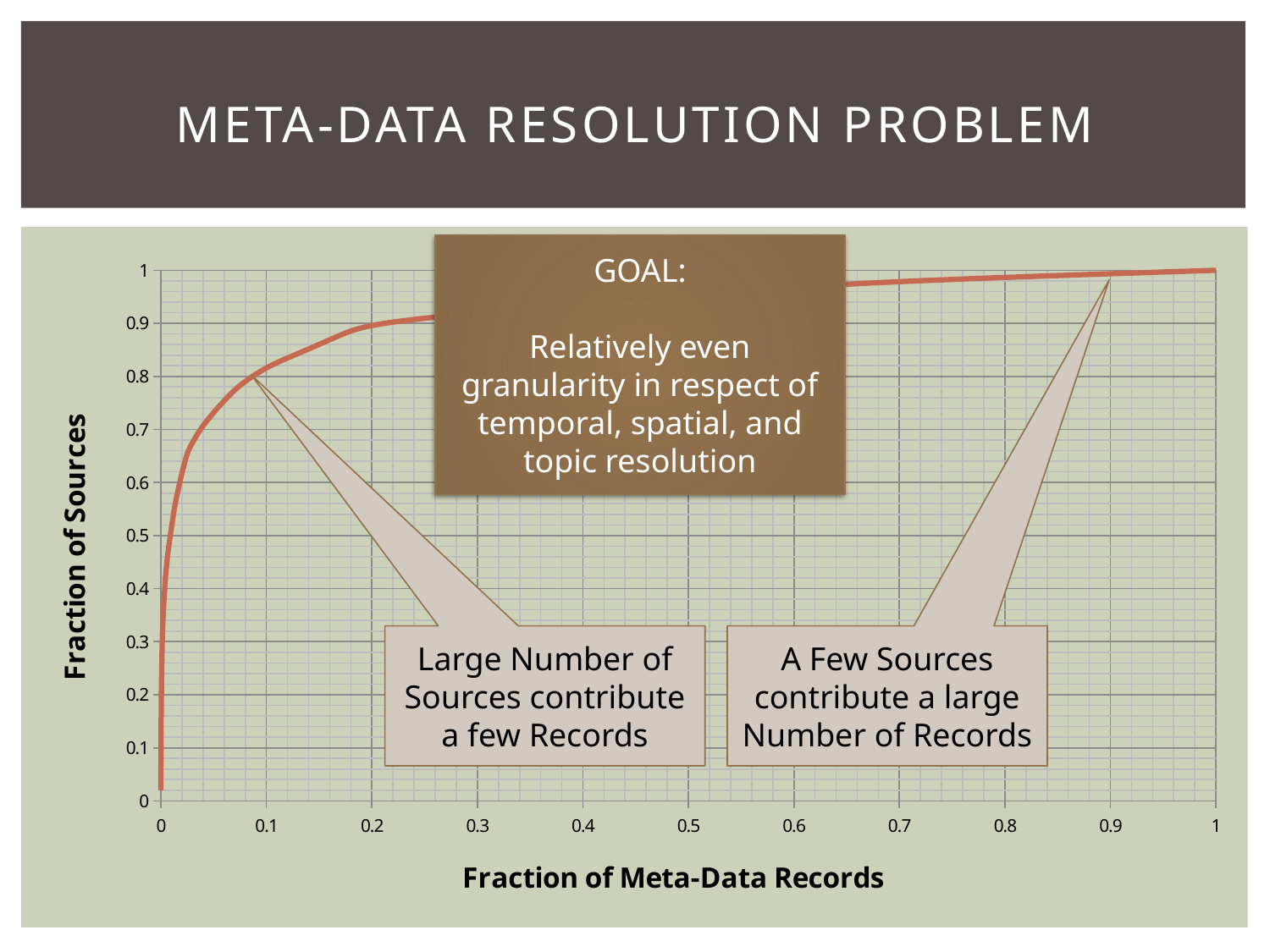
Does the plotted curve rise or fall as the fraction of meta-data records increases along the x axis? rise Which is larger: the curve's value at a fraction of meta-data records of 0.1 or at 0.9? 0.9 Is the value of the curve at a fraction of meta-data records of 0.9 greater or less than 0.9? greater What is the label of the x axis? Fraction of Meta-Data Records Is the value of the curve at a fraction of meta-data records of 0.1 greater or less than 0.9? less What is the highest value shown on the y axis? 1 Is the value of the curve at a fraction of meta-data records of 0.1 greater or less than 0.7? greater What kind of chart is shown on the slide? line chart